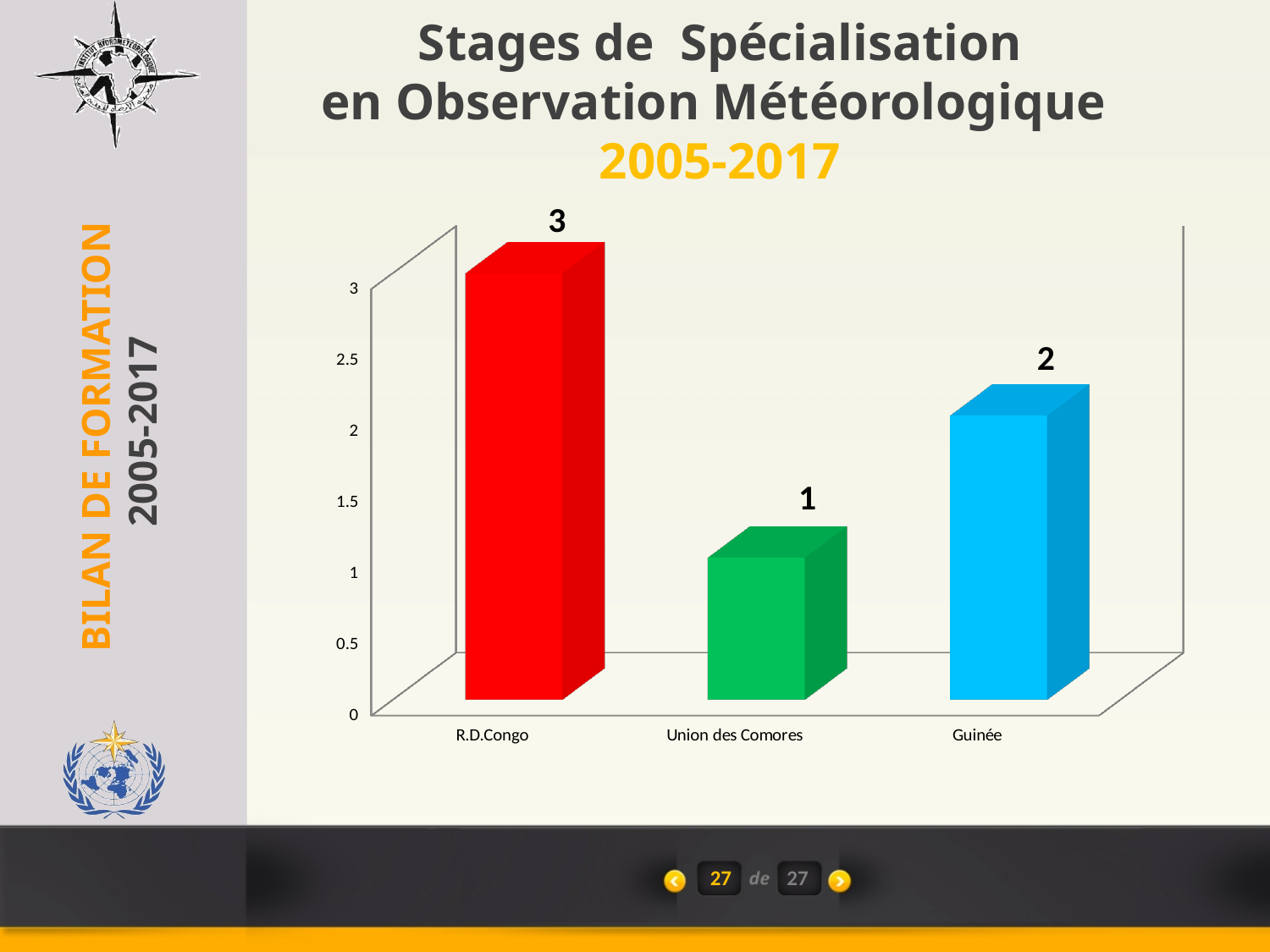
What is the value for Union des Comores? 1 What is the difference between the values for R.D.Congo and Guinée? 1 Which is larger, the value for Guinée or the value for Union des Comores? Guinée What kind of chart is shown on the slide? bar chart How many categories are shown on the x axis? 3 What is the value for R.D.Congo? 3 What is the value for Guinée? 2 Which category has the lowest value? Union des Comores Is the value for R.D.Congo greater or less than 2.5? greater What is the difference between the values for Guinée and Union des Comores? 1 What colour is the bar for Union des Comores? green Which category has the highest value? R.D.Congo